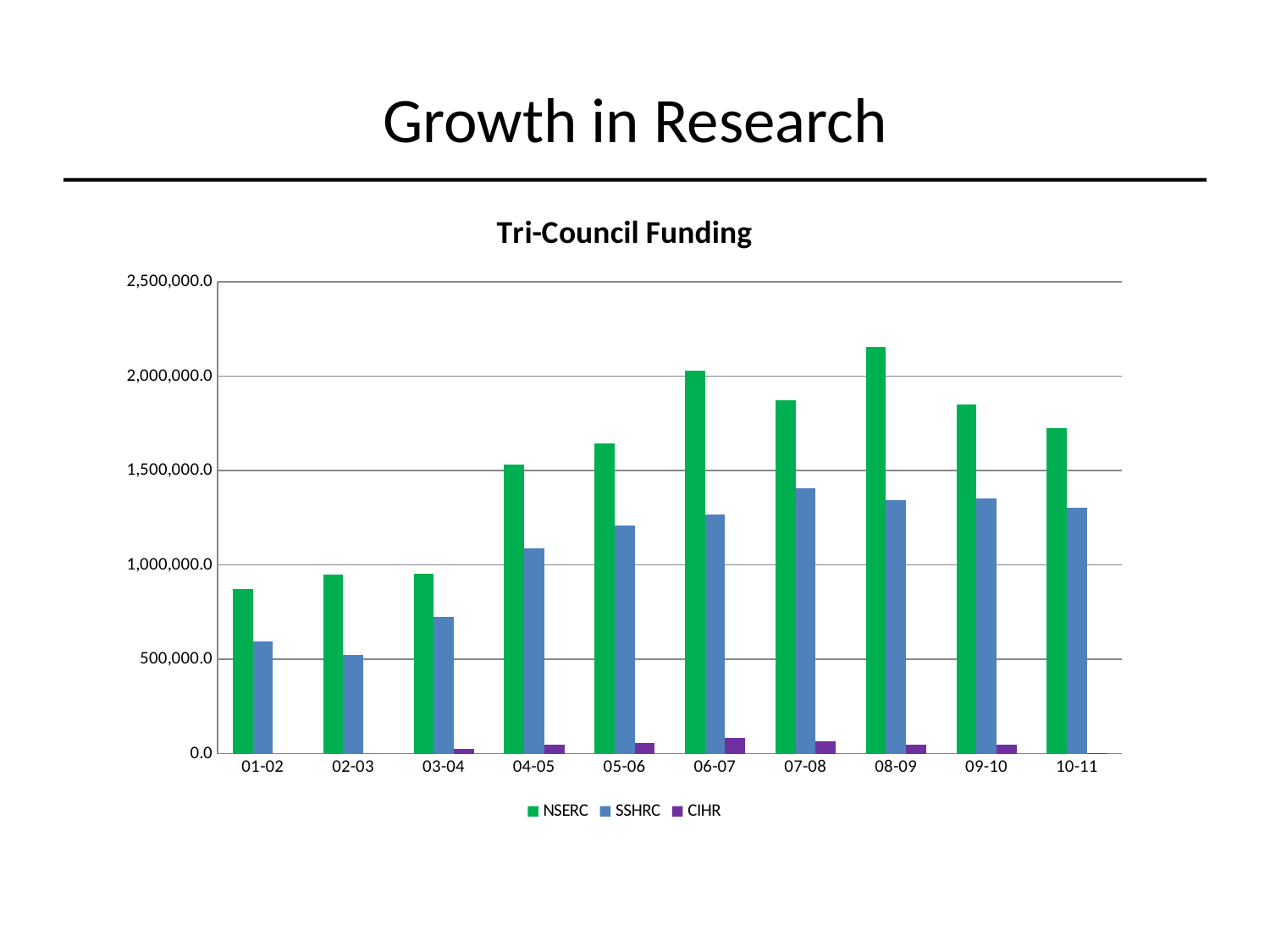
In which year is SSHRC funding lowest? 02-03 Is the SSHRC value for 07-08 greater or less than 1,500,000.0? less In which year is NSERC funding lowest? 01-02 How many fiscal years are shown on the x axis? 10 In 05-06, which is larger, NSERC or SSHRC funding? NSERC In which year is NSERC funding highest? 08-09 Is the NSERC value for 01-02 greater or less than 1,000,000.0? less Is the NSERC value for 08-09 greater or less than 2,000,000.0? greater How many series does the legend list? 3 Which series is shown in green? NSERC What kind of chart is shown on the slide? bar chart What is the title of the chart? Tri-Council Funding